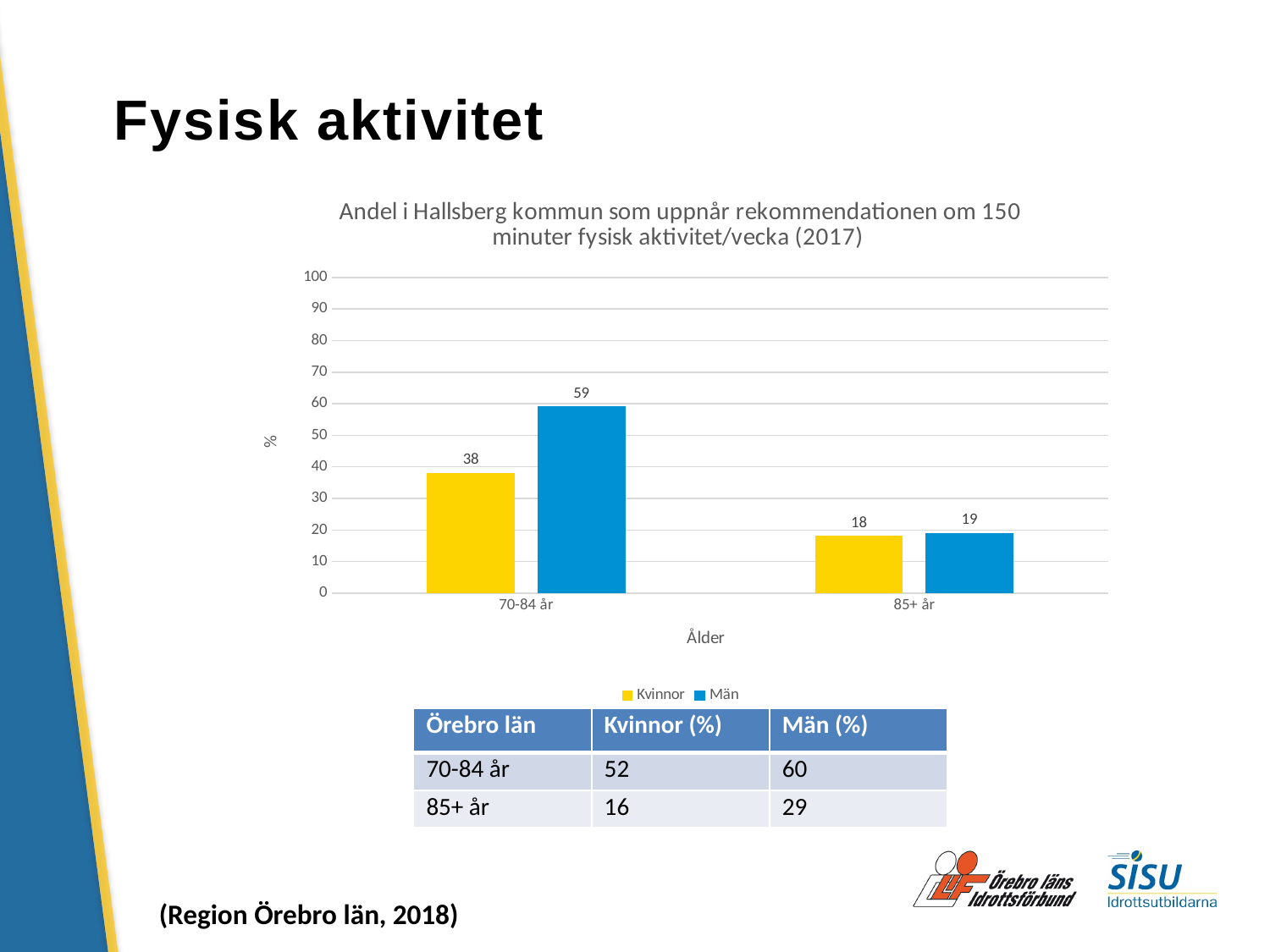
Which bar has the lowest value in the chart? Kvinnor, 85+ år How many series does the legend list? 2 What is the value for Män in the 85+ år category? 19 What kind of chart is shown on the slide? Bar chart What is the label of the y axis? % What is the value for Män in the 70-84 år category? 59 How many age categories are shown on the x axis? 2 What is the value for Kvinnor in the 70-84 år category? 38 Which bar has the highest value in the chart? Män, 70-84 år What is the value for Kvinnor in the 85+ år category? 18 Which is larger for 70-84 år, the Kvinnor value or the Män value? Män What is the difference between the Män and Kvinnor values for 70-84 år? 21